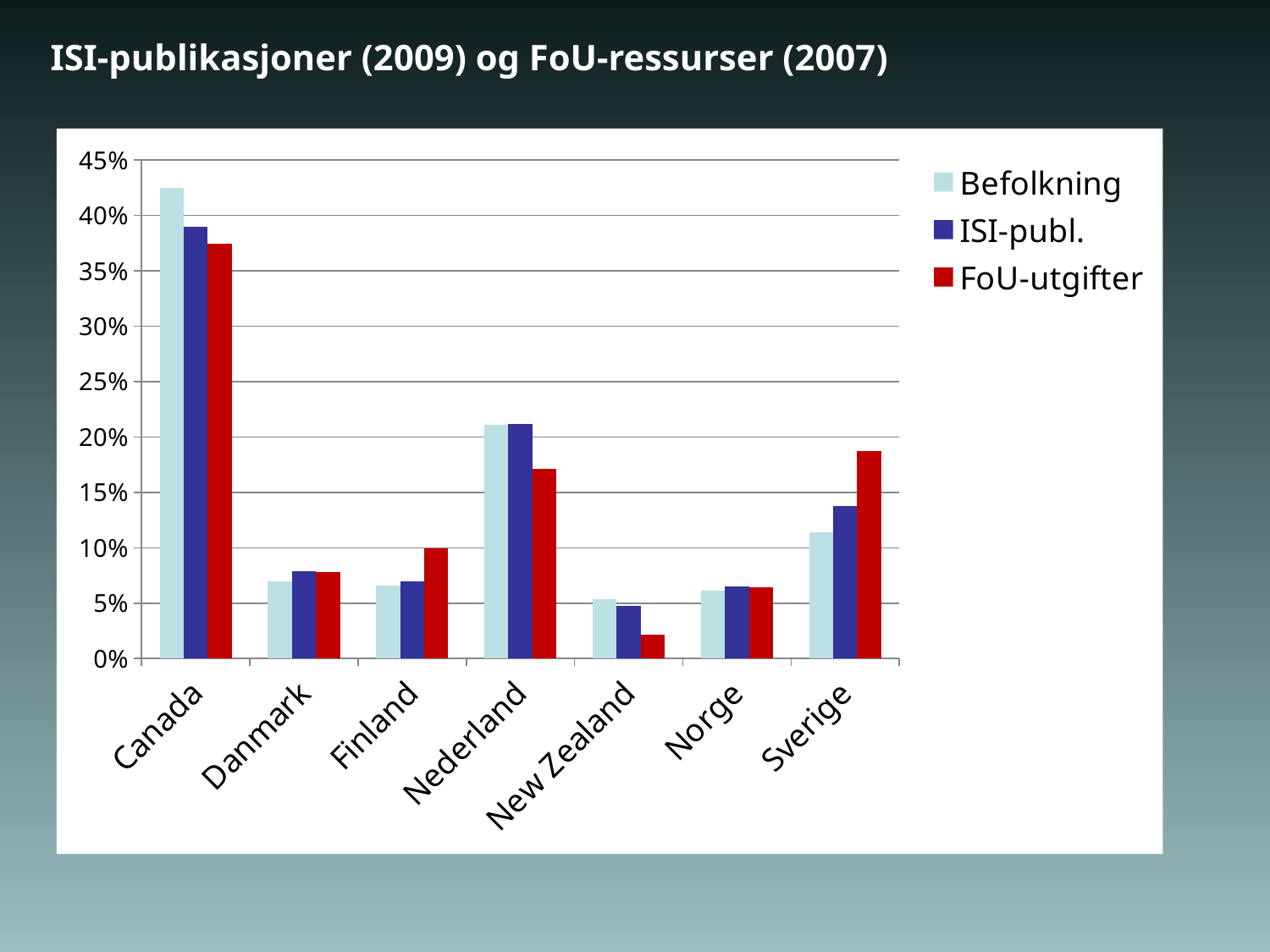
For Nederland, which is larger: Befolkning or FoU-utgifter? Befolkning Is the Befolkning value for Canada greater or less than 40%? greater Which country has the highest Befolkning value? Canada Which country has the lowest FoU-utgifter value? New Zealand Is the FoU-utgifter value for Sverige greater or less than 15%? greater Which country has the highest FoU-utgifter value? Canada How many series does the legend list? 3 For Sverige, which is larger: Befolkning or FoU-utgifter? FoU-utgifter Is the FoU-utgifter value for New Zealand greater or less than 5%? less What kind of chart is shown on the slide? bar chart How many countries are shown on the x axis? 7 What are the three series named in the legend? Befolkning, ISI-publ., FoU-utgifter